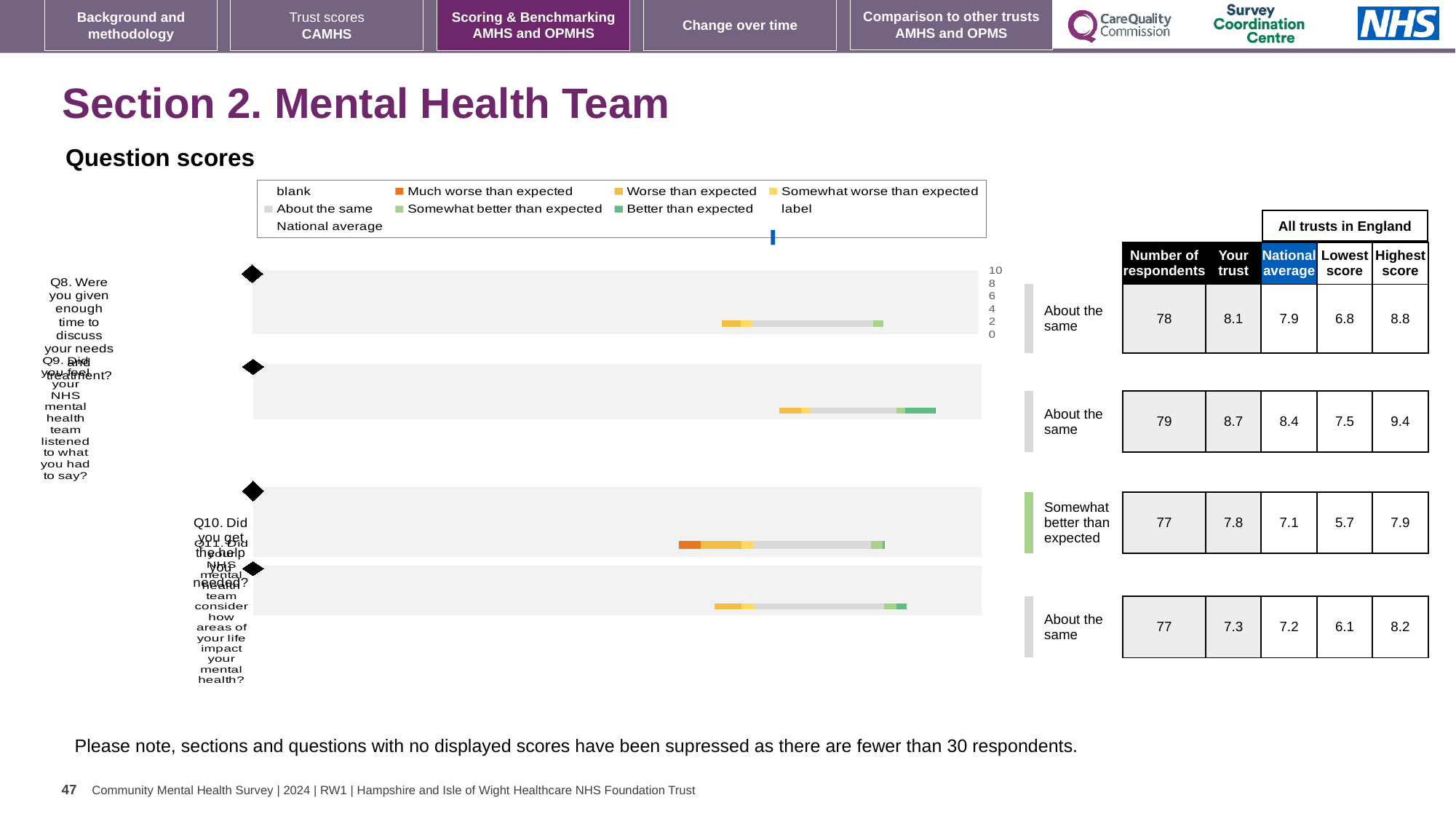
What kind of chart is used to show the question scores on this slide? bar chart What is the difference between the 'Your trust' score and the national average for Q9? 0.3 What is the difference between the highest score and the lowest score across all trusts in England for Q10? 2.2 What benchmark category is shown for Q10 (Did you get the help you needed?)? Somewhat better than expected What is the 'Your trust' score for Q8 (Were you given enough time to discuss your needs and treatment?)? 8.1 What is the national average score for Q9 (Did you feel your NHS mental health team listened to what you had to say?)? 8.4 How many respondents answered Q9? 79 According to the legend, what does the blue marker in the chart represent? National average Which question has the lowest 'Your trust' score? Q11 For Q8, which is larger: the 'Your trust' score or the national average? Your trust Which question has the highest 'Your trust' score? Q9 How many questions (Q8 to Q11) are plotted in the question scores chart? 4